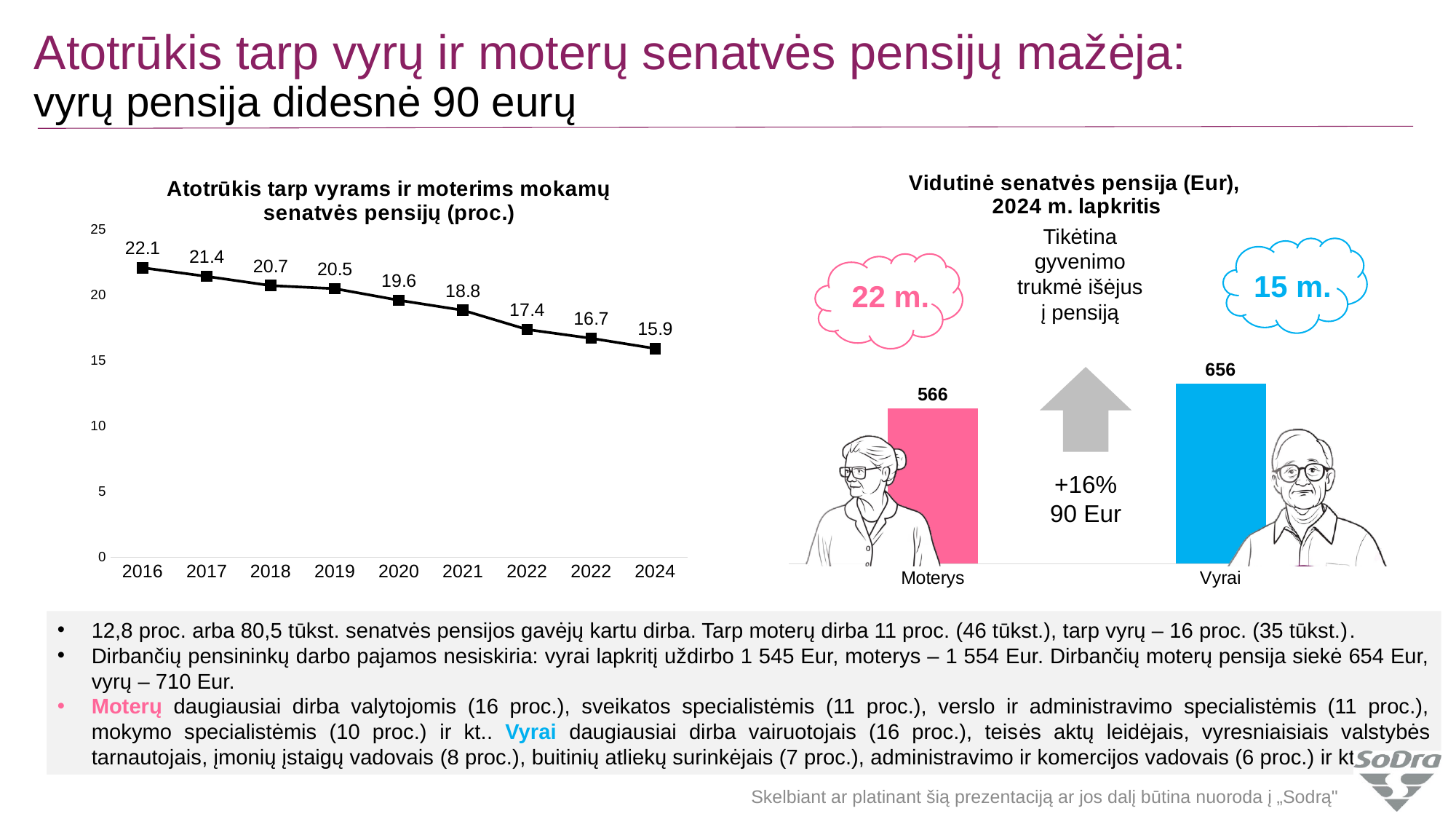
In the line chart on the left, which year has the highest value? 2016 In the line chart 'Atotrūkis tarp vyrams ir moterims mokamų senatvės pensijų (proc.)', what is the value for 2016? 22.1 In the line chart on the left, what is the difference between the 2016 value and the 2024 value? 6.2 In the line chart 'Atotrūkis tarp vyrams ir moterims mokamų senatvės pensijų (proc.)', what is the value for 2020? 19.6 How many data points are plotted in the line chart on the left? 9 In the chart 'Vidutinė senatvės pensija (Eur), 2024 m. lapkritis', what is the value for Moterys? 566 In the line chart on the left, which year has the lowest value? 2024 In the line chart on the left, do the values rise or fall from 2016 to 2024? fall In the line chart 'Atotrūkis tarp vyrams ir moterims mokamų senatvės pensijų (proc.)', what is the value for 2024? 15.9 What kind of chart is the chart on the left of the slide? line chart In the chart 'Vidutinė senatvės pensija (Eur), 2024 m. lapkritis', what is the difference between the Vyrai and Moterys values? 90 In the chart 'Vidutinė senatvės pensija (Eur), 2024 m. lapkritis', what is the value for Vyrai? 656